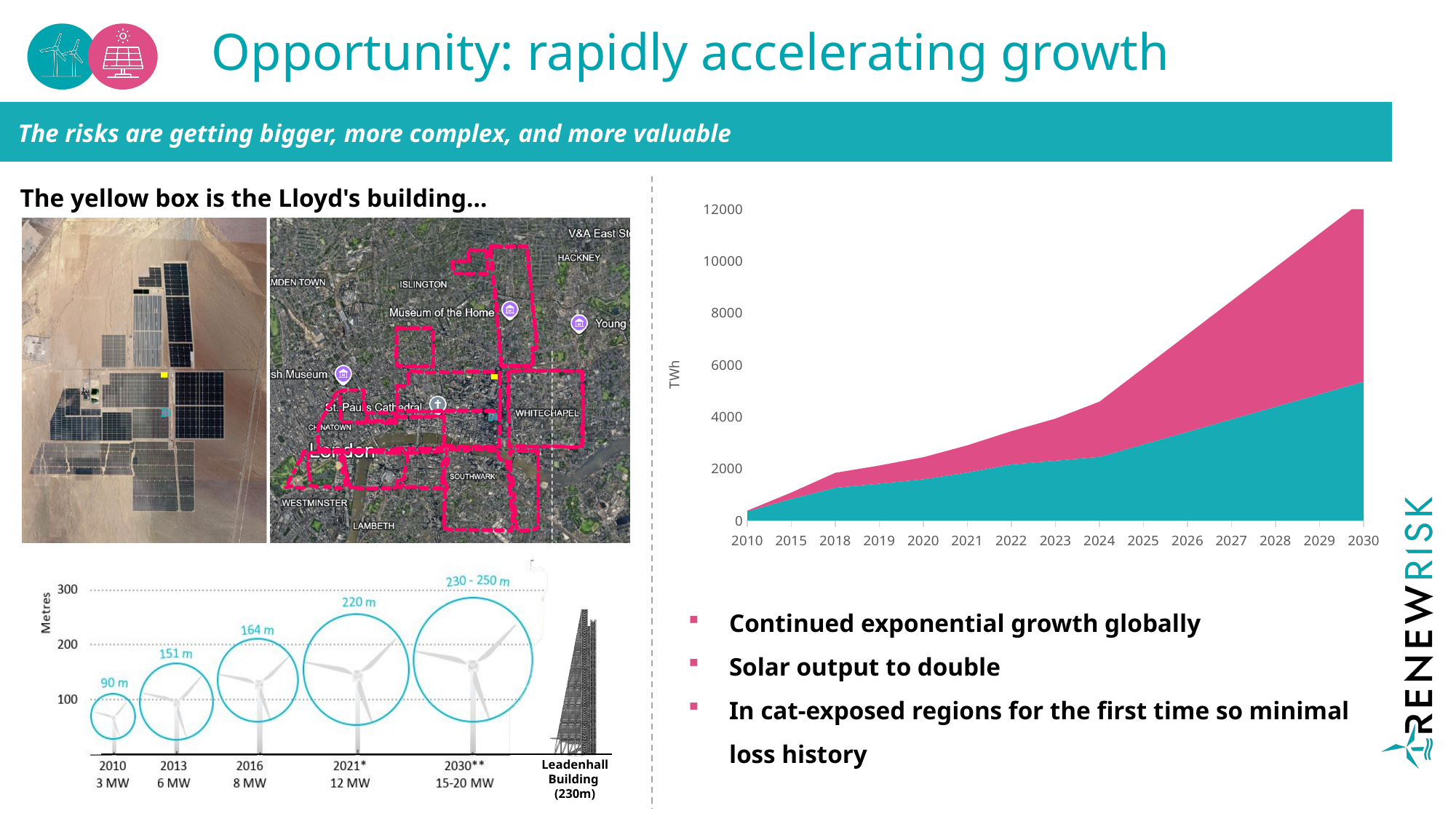
In the TWh area chart on the right, is the total stacked value for 2024 greater or less than 4000? greater How many years are labelled on the x axis of the TWh area chart on the right? 15 In the turbine size chart at the bottom left, what capacity is shown for 2013? 6 MW In the turbine size chart at the bottom left, what rotor size is labelled for 2030**? 230 - 250 m What is the label on the vertical axis of the area chart on the right? TWh In the turbine size chart at the bottom left, what is the difference in metres between the 2021* turbine (220 m) and the 2016 turbine (164 m)? 56 m In the TWh area chart on the right, is the total stacked value for 2027 greater or less than 6000? greater What kind of chart is the chart on the right of the slide showing TWh from 2010 to 2030? Stacked area chart In the turbine size chart at the bottom left, what rotor size is labelled for 2016? 164 m In the TWh area chart on the right, is the teal (bottom) series value for 2030 greater or less than 4000? greater In the TWh area chart on the right, do the values rise or fall from 2010 to 2030? Rise